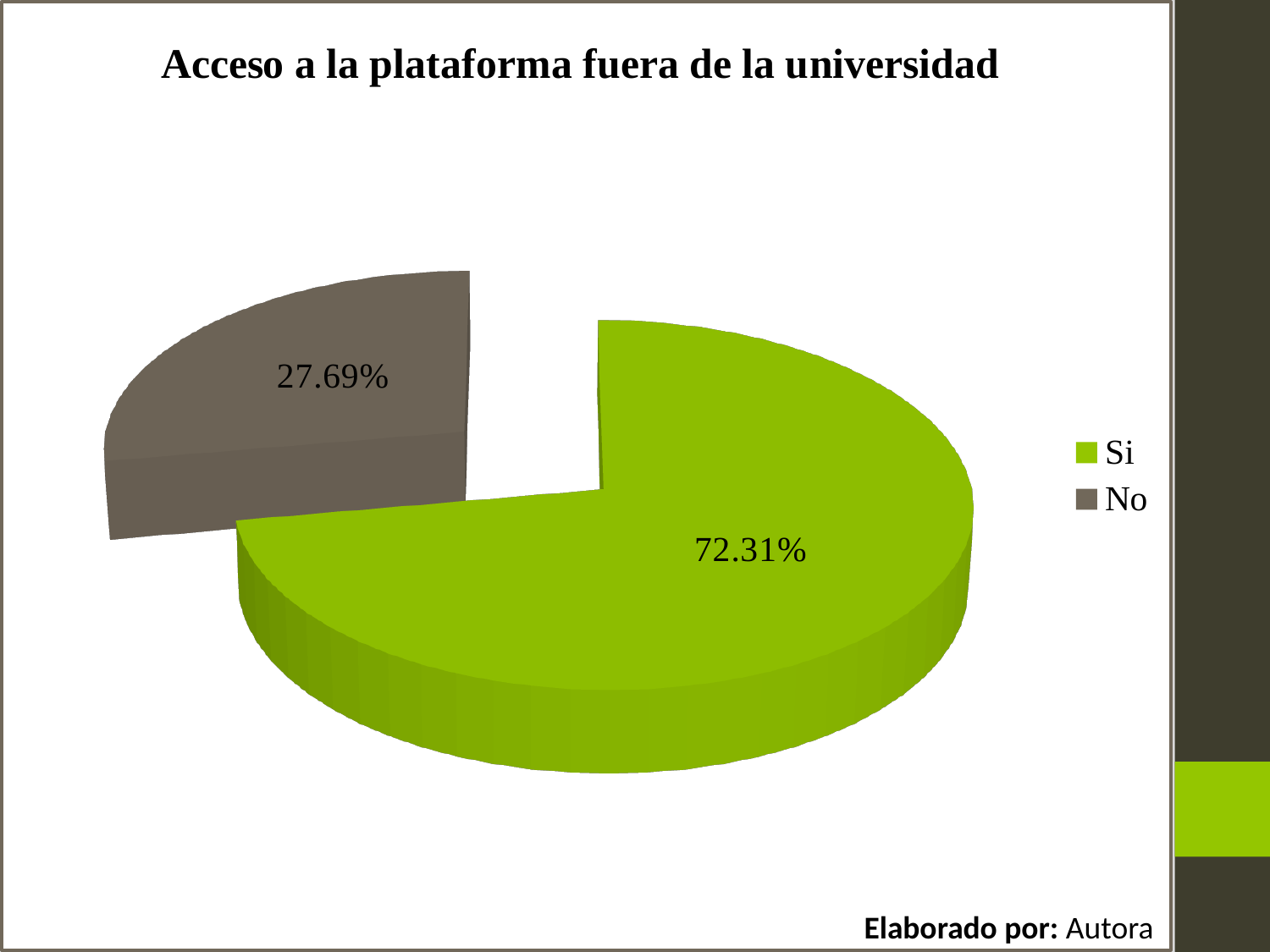
How many slices does the pie chart have? 2 What colour is the 'No' slice? grey Which category has the smallest share of the pie? No What percentage is shown for the 'No' slice? 27.69% What is the difference in percentage points between the 'Si' and 'No' slices? 44.62 Which is larger, the 'Si' slice or the 'No' slice? Si What kind of chart is shown on the slide? pie chart Which category has the largest share of the pie? Si What is the title of the chart? Acceso a la plataforma fuera de la universidad How many entries does the legend list? 2 What percentage is shown for the 'Si' slice? 72.31% What share of the pie does the 'Si' slice represent? 72.31%